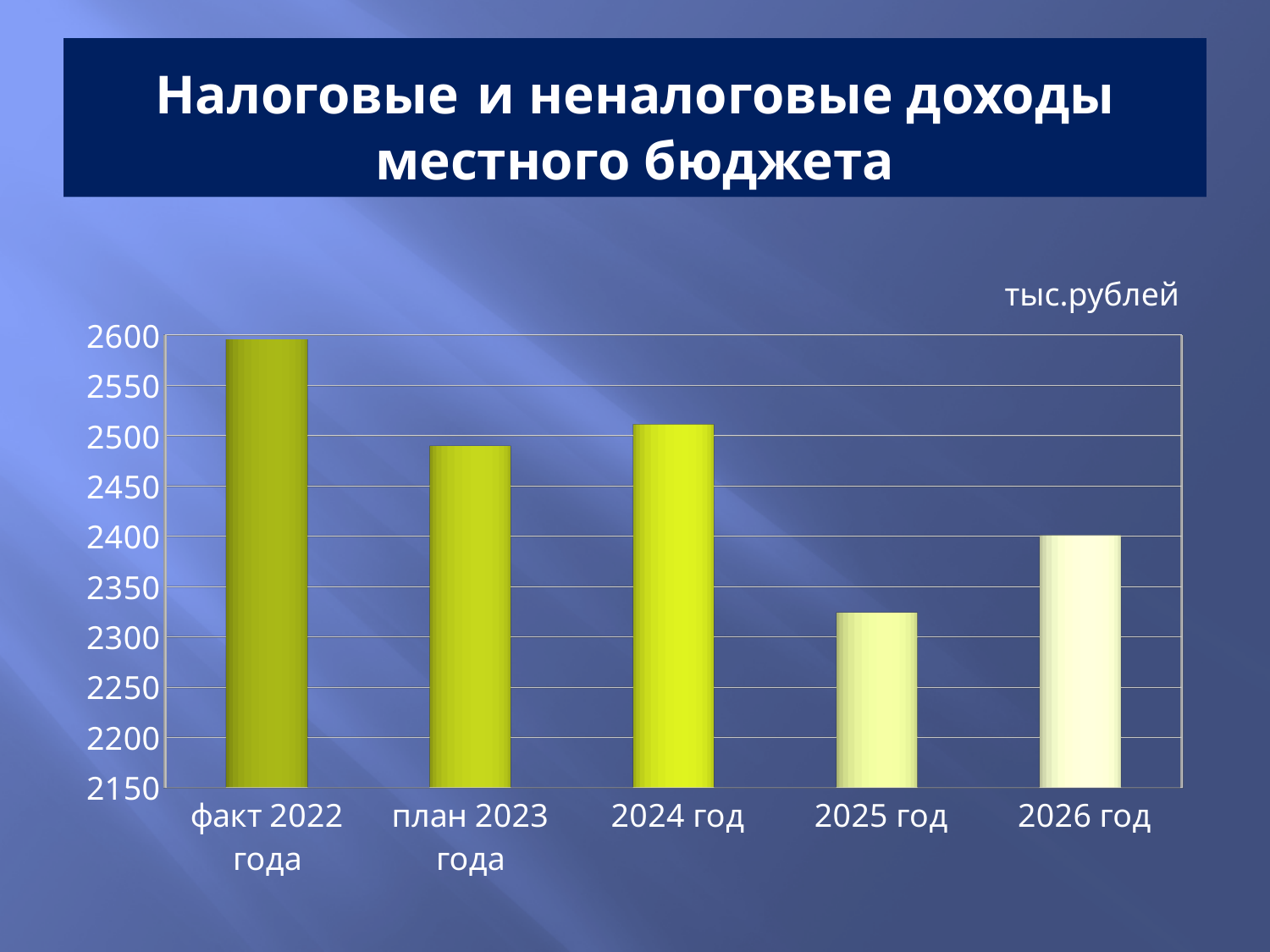
Which category has the highest value in the chart? факт 2022 года Does the value rise or fall from 2024 год to 2025 год? fall Which is larger, the value for 2025 год or the value for 2026 год? 2026 год What type of chart is shown on the slide? bar chart Which category has the lowest value in the chart? 2025 год Is the value for 2025 год greater or less than 2350? less Is the value for факт 2022 года greater or less than 2550? greater Is the value for 2024 год greater or less than 2500? greater What is the title of the slide? Налоговые и неналоговые доходы местного бюджета How many categories are shown on the x axis of the chart? 5 What unit is indicated above the chart? тыс.рублей